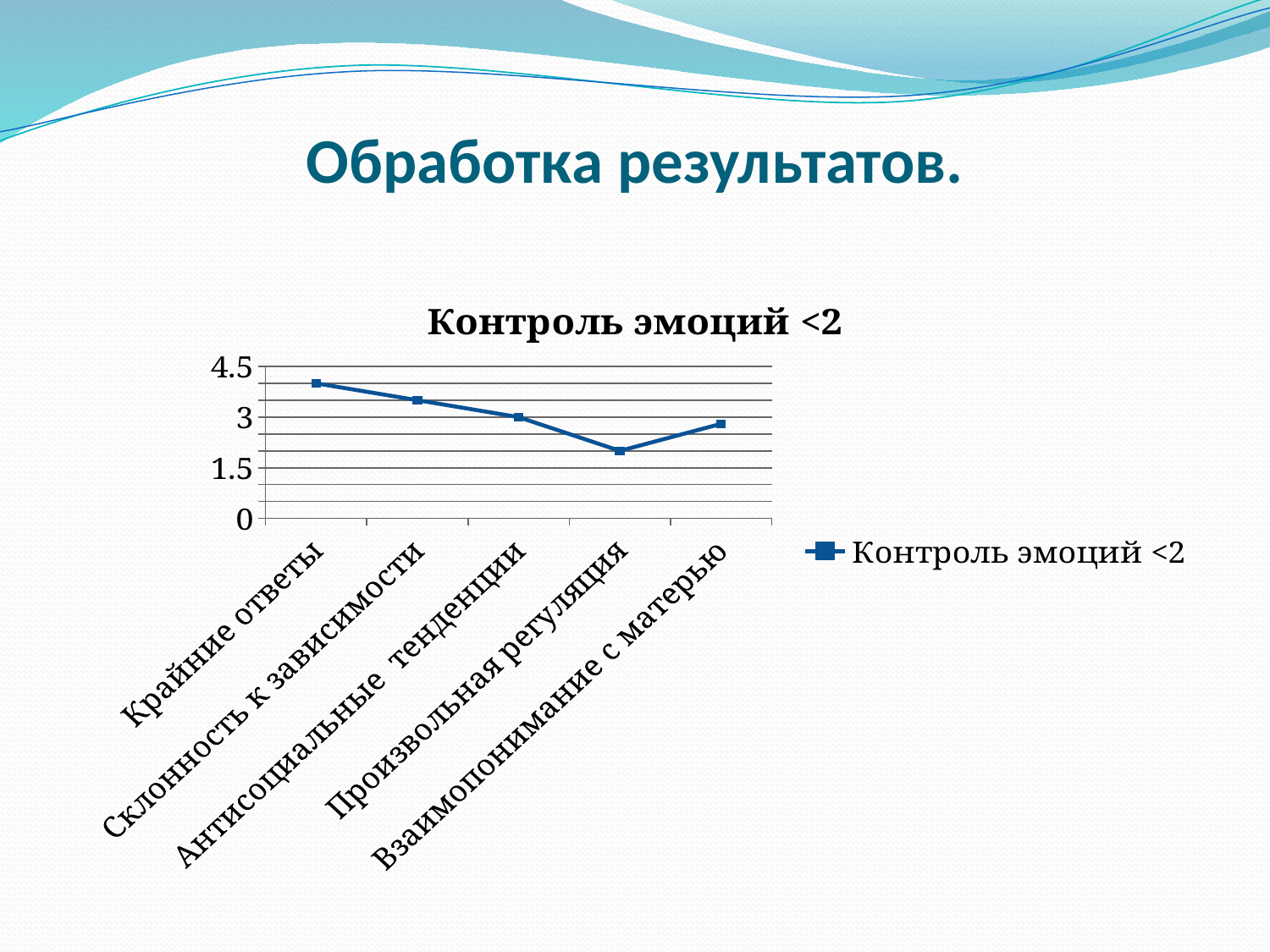
What kind of chart is shown on the slide? line chart Do the values rise or fall from Крайние ответы to Произвольная регуляция? fall How many series does the legend list? 1 Which is larger, the value for Крайние ответы or the value for Произвольная регуляция? Крайние ответы How many categories are plotted along the x axis? 5 What is the title of the chart? Контроль эмоций <2 Is the value for Взаимопонимание с матерью greater or less than 4.5? less Which category has the lowest value? Произвольная регуляция Is the value for Произвольная регуляция greater or less than 3? less Is the value for Крайние ответы greater or less than 3? greater Which category has the highest value? Крайние ответы